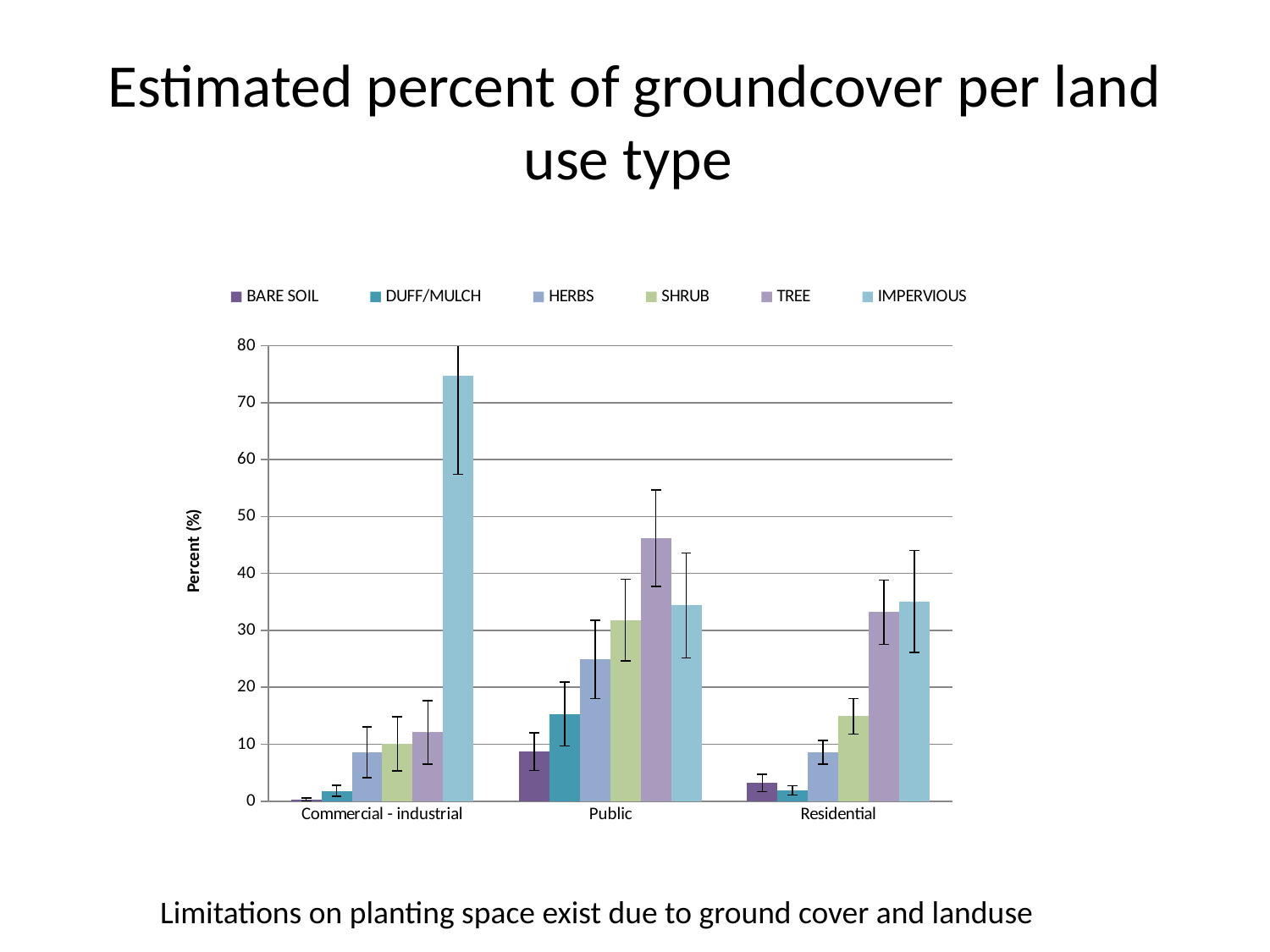
Which land use type has the highest IMPERVIOUS value? Commercial - industrial Is the TREE value for Public greater or less than 40? greater What is the label on the y axis? Percent (%) What kind of chart is shown on the slide? bar chart For Public, which groundcover type has the highest value? TREE For Residential, which is larger: SHRUB or HERBS? SHRUB How many land use types are shown on the x axis? 3 For Public, which is larger: TREE or IMPERVIOUS? TREE Is the HERBS value for Public greater or less than 20? greater For Commercial - industrial, which groundcover type has the lowest value? BARE SOIL Is the IMPERVIOUS value for Commercial - industrial greater or less than 70? greater How many series does the legend list? 6